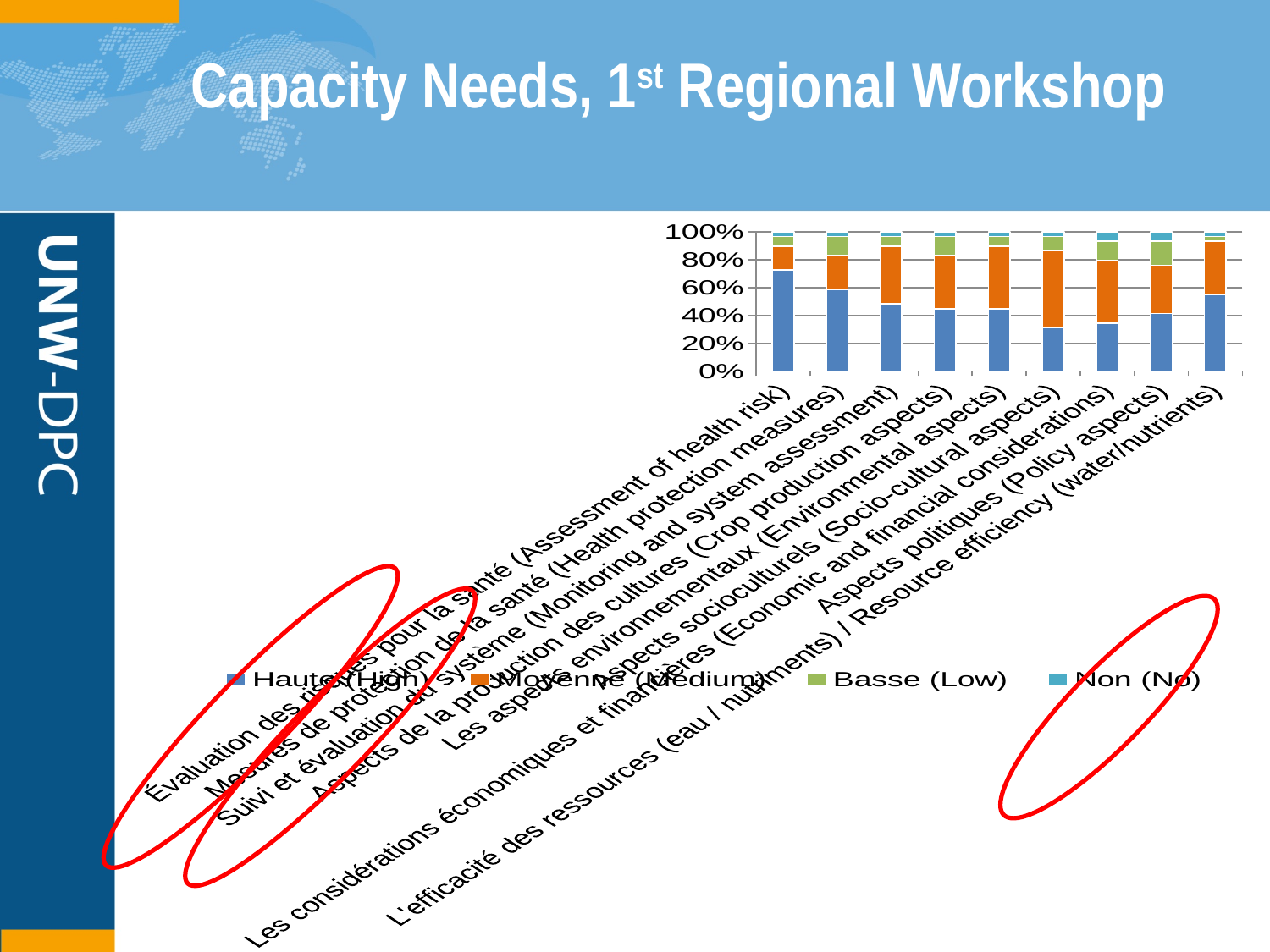
Which series are listed in the chart legend? Haute (High), Moyenne (Medium), Basse (Low), Non (No) What kind of chart is shown on the slide? Stacked bar chart Is the Haute (High) share for Socio-cultural aspects greater or less than 40%? less Which category has the largest Haute (High) share? Évaluation des risques pour la santé (Assessment of health risk) Is the Haute (High) share for Assessment of health risk greater or less than 60%? greater How many series does the legend list? 4 Which has the larger Haute (High) share: Assessment of health risk or Socio-cultural aspects? Assessment of health risk What do the segments of each stacked bar add up to? 100% Is the Haute (High) share for Resource efficiency (water/nutrients) greater or less than 40%? greater How many categories (bars) does the chart show? 9 What colour represents the Haute (High) series in the chart? Blue